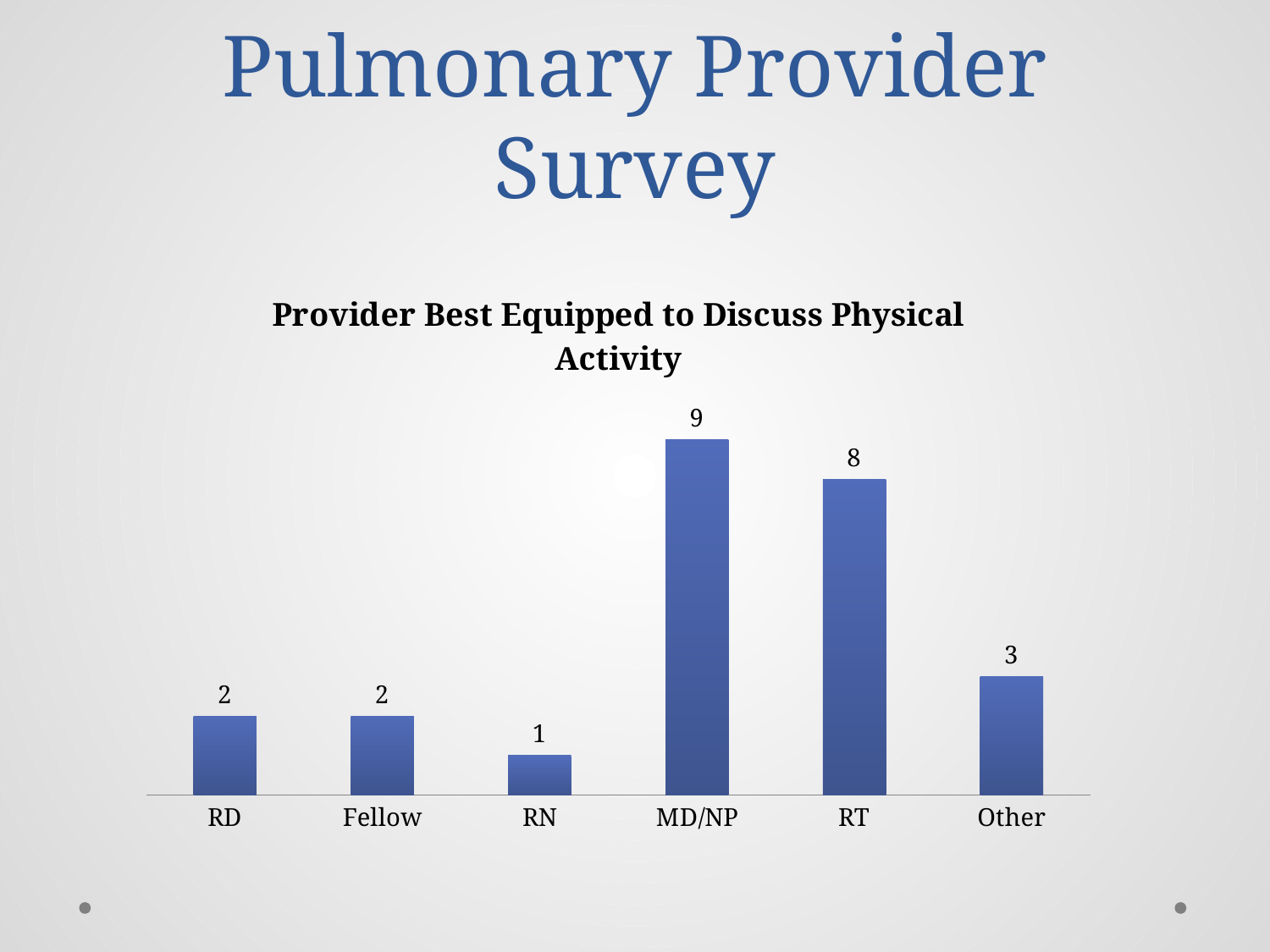
Which category has the lowest value? RN What is the difference between the values for MD/NP and RT? 1 What is the value for MD/NP? 9 How many categories are shown on the x axis? 6 Which is larger, the value for Other or the value for Fellow? Other What kind of chart is shown? Bar chart Which category has the highest value? MD/NP What is the value for RT? 8 What is the value for RN? 1 What is the value for Other? 3 What is the title of the chart? Provider Best Equipped to Discuss Physical Activity What is the difference between the values for RT and Other? 5